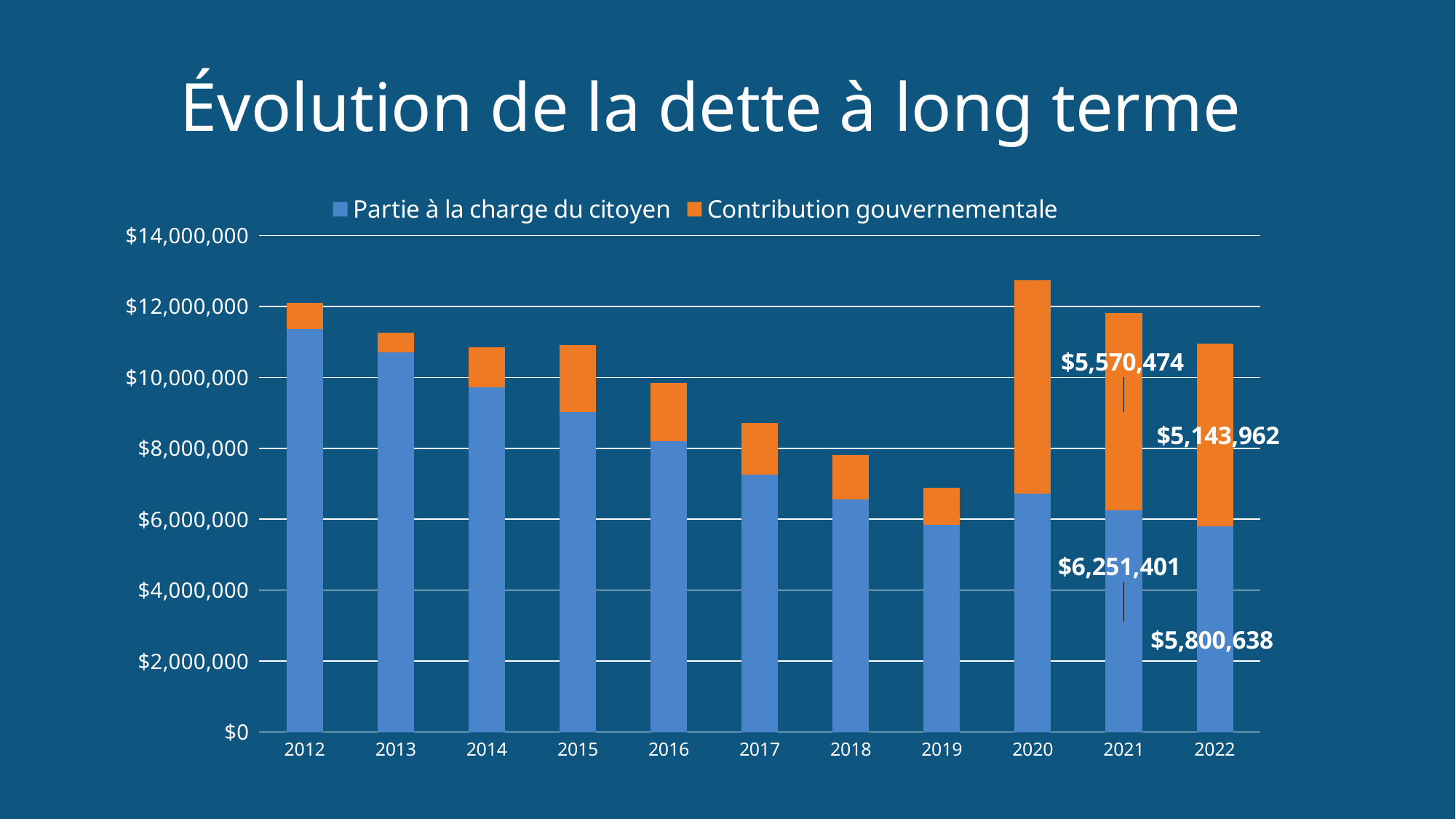
What is the difference between 'Partie à la charge du citoyen' in 2021 and in 2022? $450,763 How many years are shown on the x axis? 11 What type of chart is shown on the slide? Stacked bar chart How many series does the legend list? 2 Is the total for 2019 greater or less than $8,000,000? less Does 'Partie à la charge du citoyen' rise or fall from 2012 to 2019? Fall Which year has the highest total long-term debt? 2020 What is the value of 'Partie à la charge du citoyen' for 2021? $6,251,401 What is the value of 'Partie à la charge du citoyen' for 2022? $5,800,638 What is the value of 'Contribution gouvernementale' for 2021? $5,570,474 What is the total of the stacked bar for 2021? $11,821,875 What is the value of 'Contribution gouvernementale' for 2022? $5,143,962